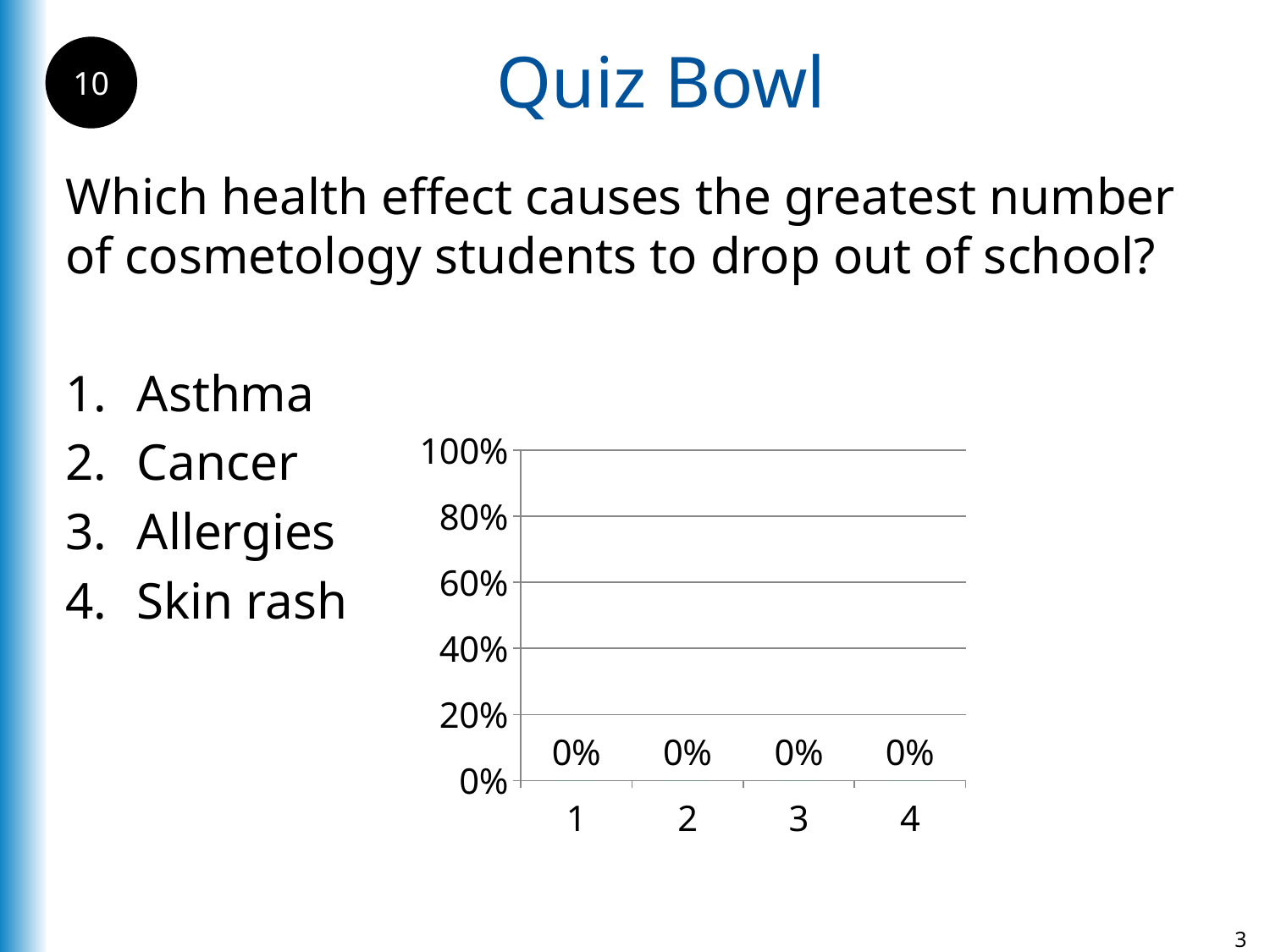
What is the highest value labelled on the y axis of the chart? 100% How many categories are shown on the x axis of the chart? 4 What is the value shown for category 3? 0% What is the difference between the values for category 1 and category 4? 0% What is the value shown for category 1? 0% Do the values rise, fall, or stay the same from category 1 to category 4? stay the same What kind of chart is shown on the slide? bar chart What is the interval between the tick labels on the y axis of the chart? 20% What is the value shown for category 2? 0% What is the value shown for category 4? 0%